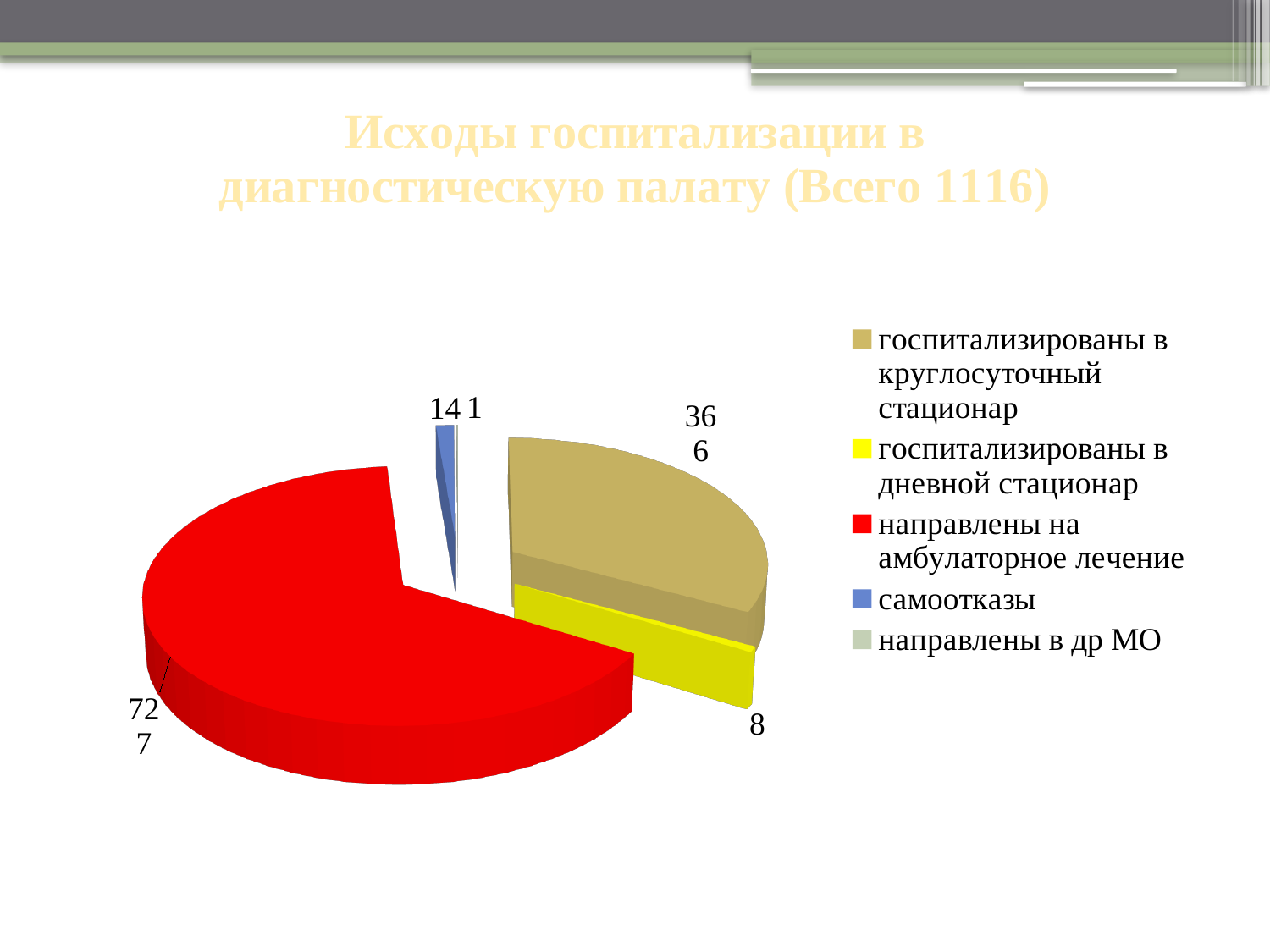
What total is stated in the chart title? 1116 What kind of chart is shown on the slide? pie chart How many categories does the legend list? 5 What is the value for "самоотказы"? 14 Which category has the largest slice of the pie? направлены на амбулаторное лечение What is the value for "направлены на амбулаторное лечение"? 727 What is the difference between the values for "направлены на амбулаторное лечение" and "госпитализированы в круглосуточный стационар"? 361 Which colour represents "направлены на амбулаторное лечение"? red Which is larger: the value for "самоотказы" or the value for "госпитализированы в дневной стационар"? самоотказы What is the value for "госпитализированы в круглосуточный стационар"? 366 Which category has the smallest value? направлены в др МО What is the value for "госпитализированы в дневной стационар"? 8